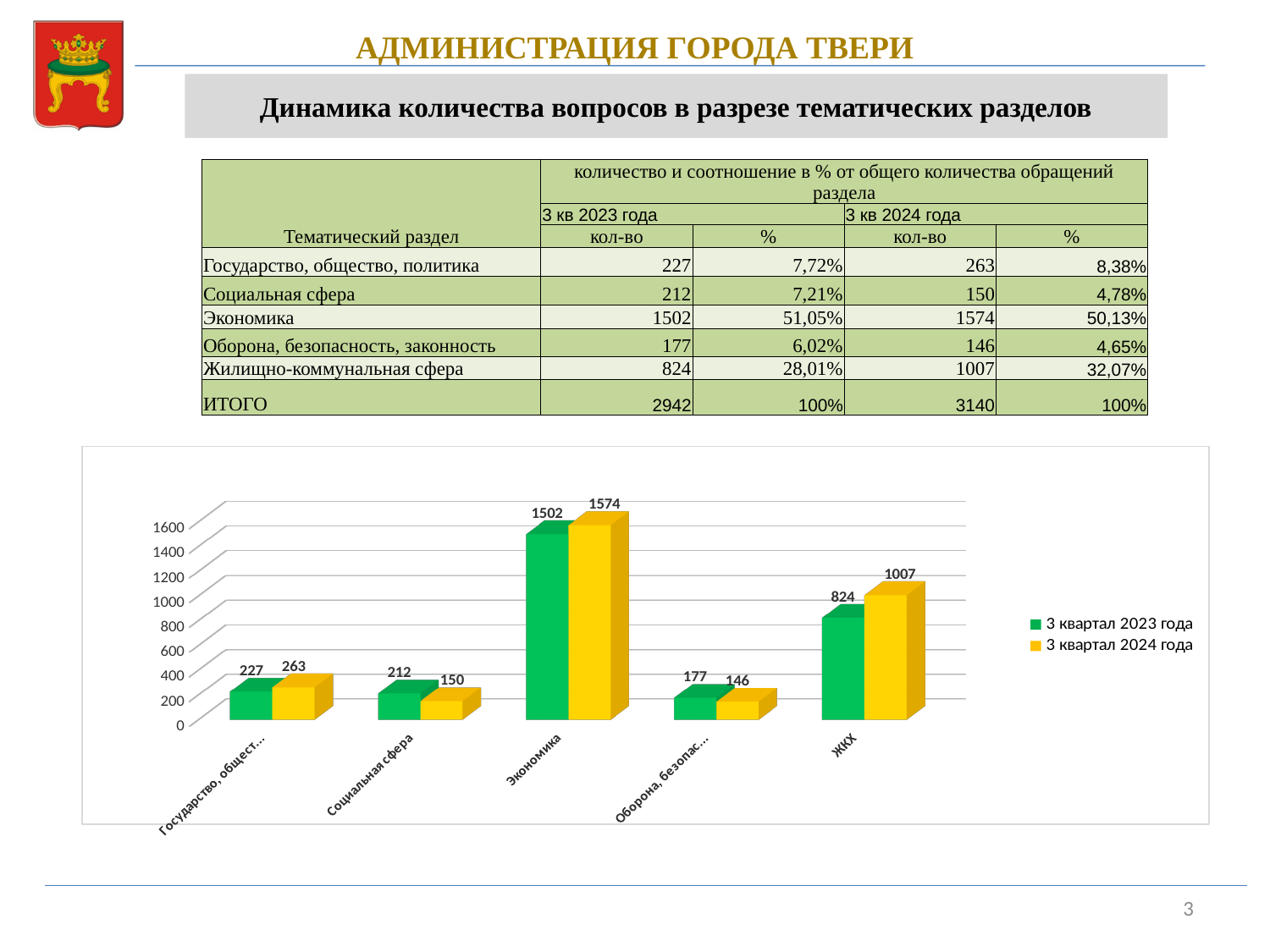
How many categories are shown on the chart's x axis? 5 Which category has the highest value in the series 3 квартал 2023 года? Экономика Which colour represents the series 3 квартал 2024 года in the chart? yellow What is the difference between the 3 квартал 2024 года and 3 квартал 2023 года values for ЖКХ? 183 How many series does the chart legend list? 2 Is the value for ЖКХ in the series 3 квартал 2024 года greater or less than 1000? greater What kind of chart is shown on the slide? bar chart What is the value for Экономика in the series 3 квартал 2024 года? 1574 Which category has the lowest value in the series 3 квартал 2024 года? Оборона, безопасность, законность For Социальная сфера, which series has the larger value: 3 квартал 2023 года or 3 квартал 2024 года? 3 квартал 2023 года What is the value for ЖКХ in the series 3 квартал 2023 года? 824 What is the value for Социальная сфера in the series 3 квартал 2024 года? 150